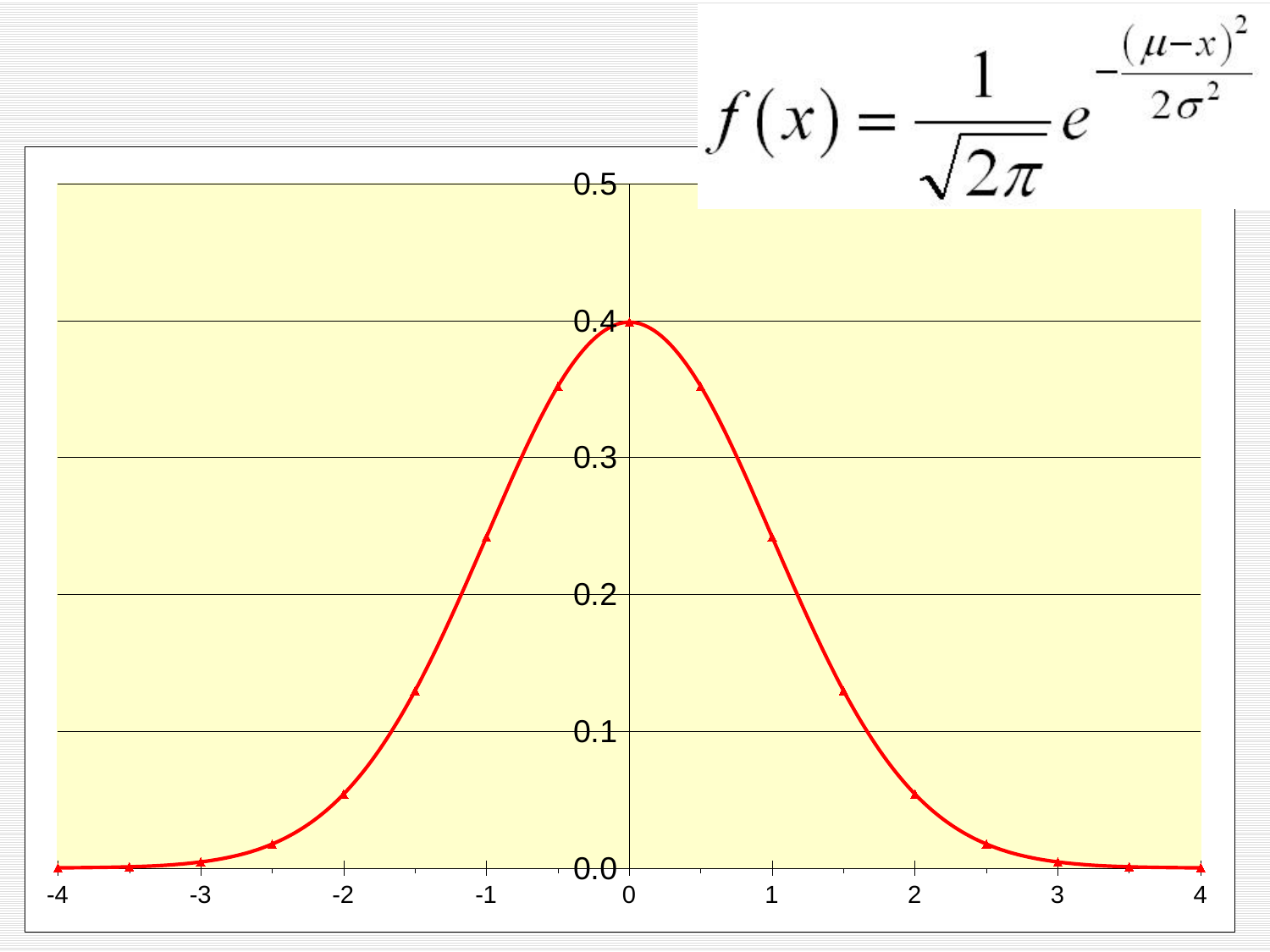
Is the value of the curve at x = -0.5 greater or less than 0.3? greater Does the curve rise or fall as x goes from -4 to 0? rise Is the value of the curve at x = 0 greater or less than 0.3? greater How many data points are marked on the curve? 17 Which is larger, the value of the curve at x = 1 or at x = 2? x = 1 Is the value of the curve at x = -2 greater or less than 0.1? less Which is larger, the value of the curve at x = -3 or at x = -1? x = -1 What kind of chart is shown on the slide? line chart At which x value does the curve reach its highest point? 0 What is the highest value shown on the y axis? 0.5